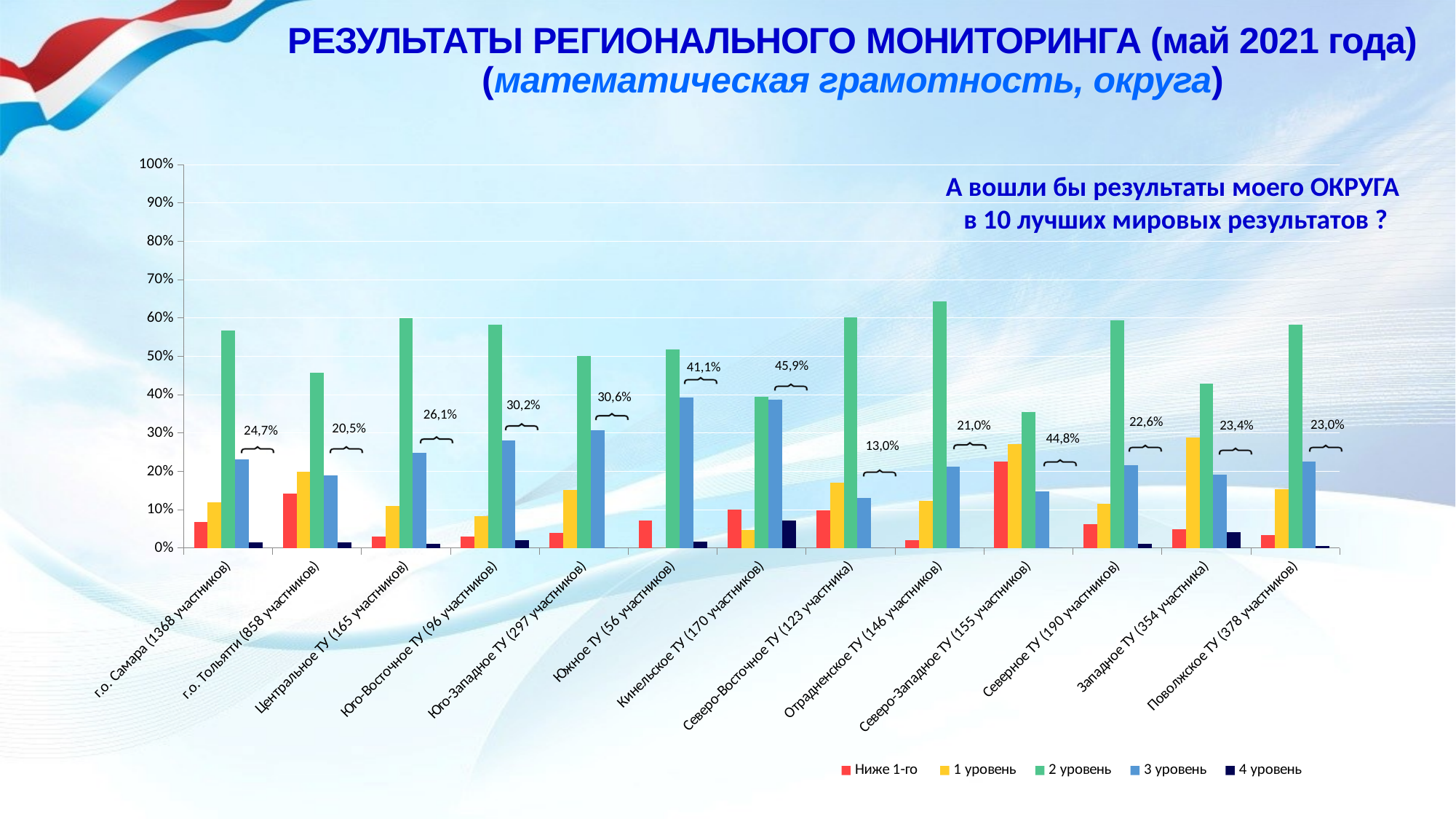
What kind of chart is shown on the slide? bar chart Which district has the lowest "2 уровень" bar? Северо-Западное ТУ (155 участников) Which district has the highest "2 уровень" bar? Отрадненское ТУ (146 участников) How many districts (categories) are shown on the x axis? 13 Is the "3 уровень" value for Северо-Восточное ТУ greater or less than 20%? less Is the "Ниже 1-го" value for Северо-Западное ТУ greater or less than 20%? greater Which is larger, the "Ниже 1-го" value for г.о. Тольятти or for г.о. Самара? г.о. Тольятти Which district has the highest "Ниже 1-го" bar? Северо-Западное ТУ (155 участников) Which district has the highest "4 уровень" bar? Кинельское ТУ (170 участников) How many series does the legend list? 5 Is the "2 уровень" value for г.о. Самара greater or less than 50%? greater Which series is shown in green in the legend? 2 уровень